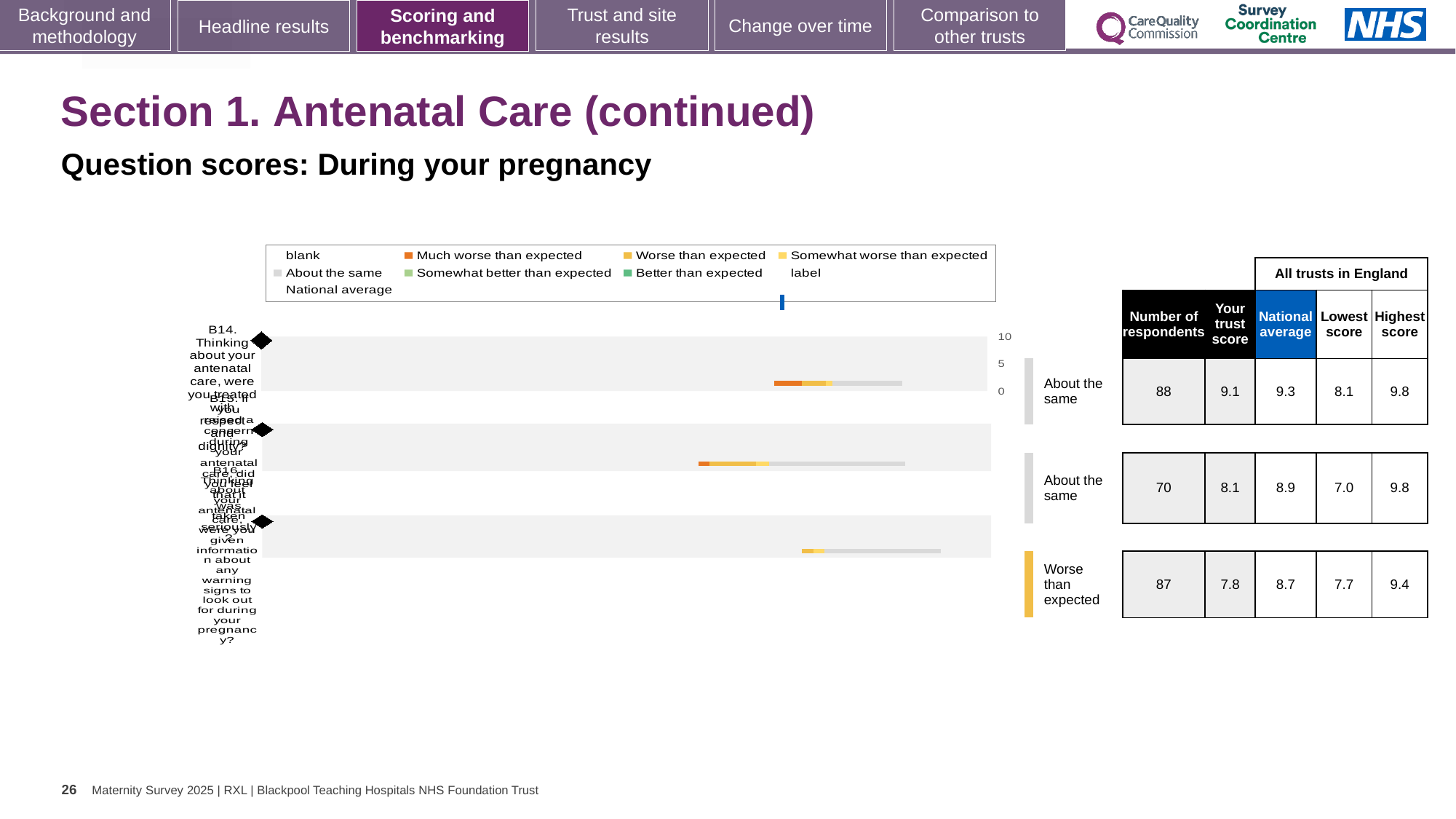
What is the highest score among all trusts in England for the second row? 9.8 What benchmark category is shown for the third row of the chart? Worse than expected For the first row, which is larger: the trust score or the national average? the national average Which row has the lowest 'Your trust score'? the third row What is the total number of respondents across the three rows? 245 For the second row, what is the difference between the national average and the trust score? 0.8 What is the number of respondents for the third row of the chart? 87 How many survey questions (rows) are plotted in the chart? 3 What is the 'Your trust score' for the first row (B14, treated with respect and dignity)? 9.1 Which row has the highest 'Your trust score'? the first row (B14) What kind of chart is shown on the slide? bar chart What is the national average for the second row of the chart? 8.9